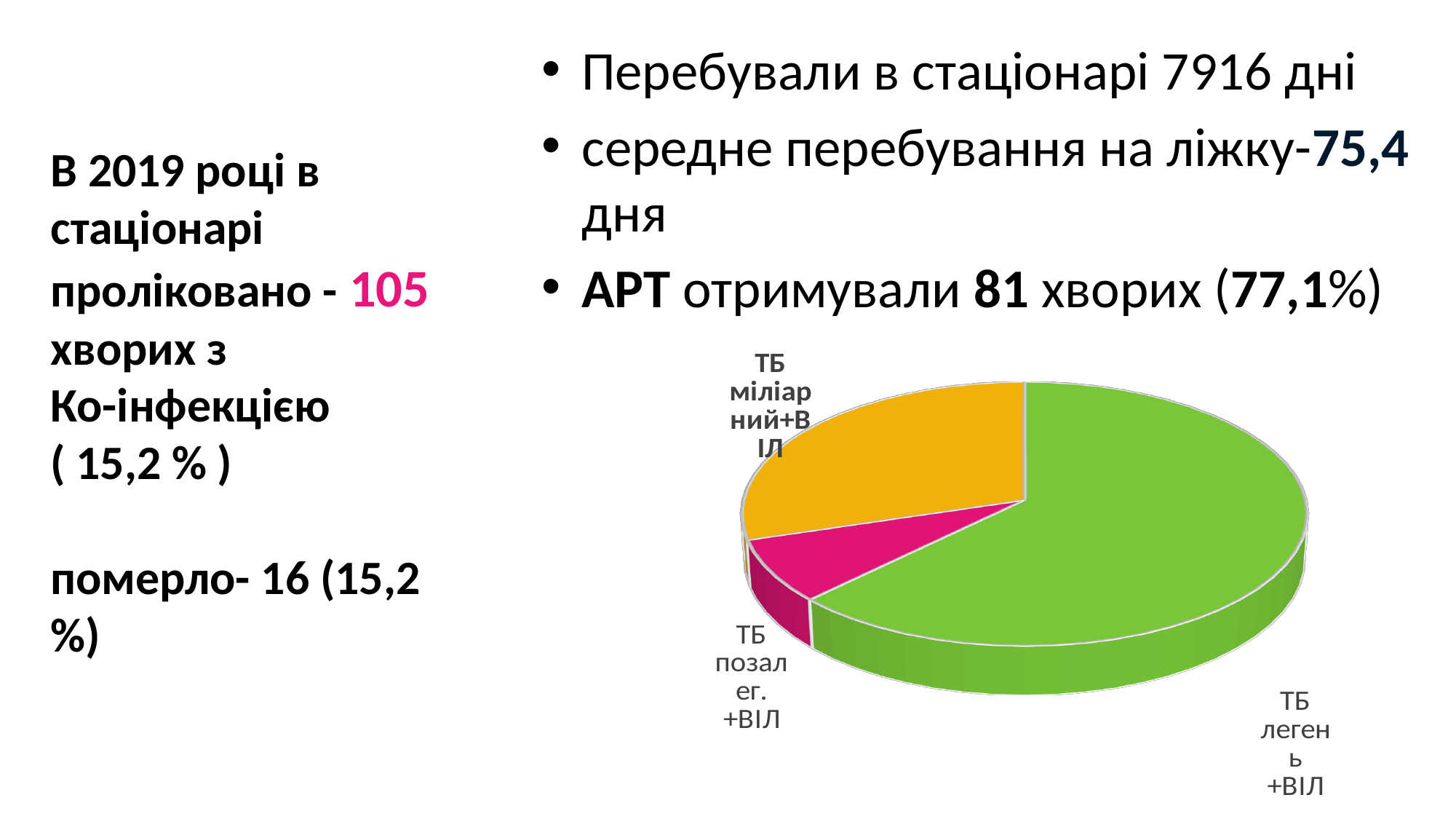
How many slices does the pie chart have? 3 What colour is the slice for ТБ міліарний+ВІЛ in the pie chart? orange What kind of chart is shown on the slide? pie chart Which slice is larger: ТБ міліарний+ВІЛ or ТБ позалег. +ВІЛ? ТБ міліарний+ВІЛ What colour is the slice for ТБ легень +ВІЛ in the pie chart? green Which category has the smallest slice of the pie chart? ТБ позалег. +ВІЛ Which slice is larger: ТБ легень +ВІЛ or ТБ міліарний+ВІЛ? ТБ легень +ВІЛ Which category has the largest slice of the pie chart? ТБ легень +ВІЛ